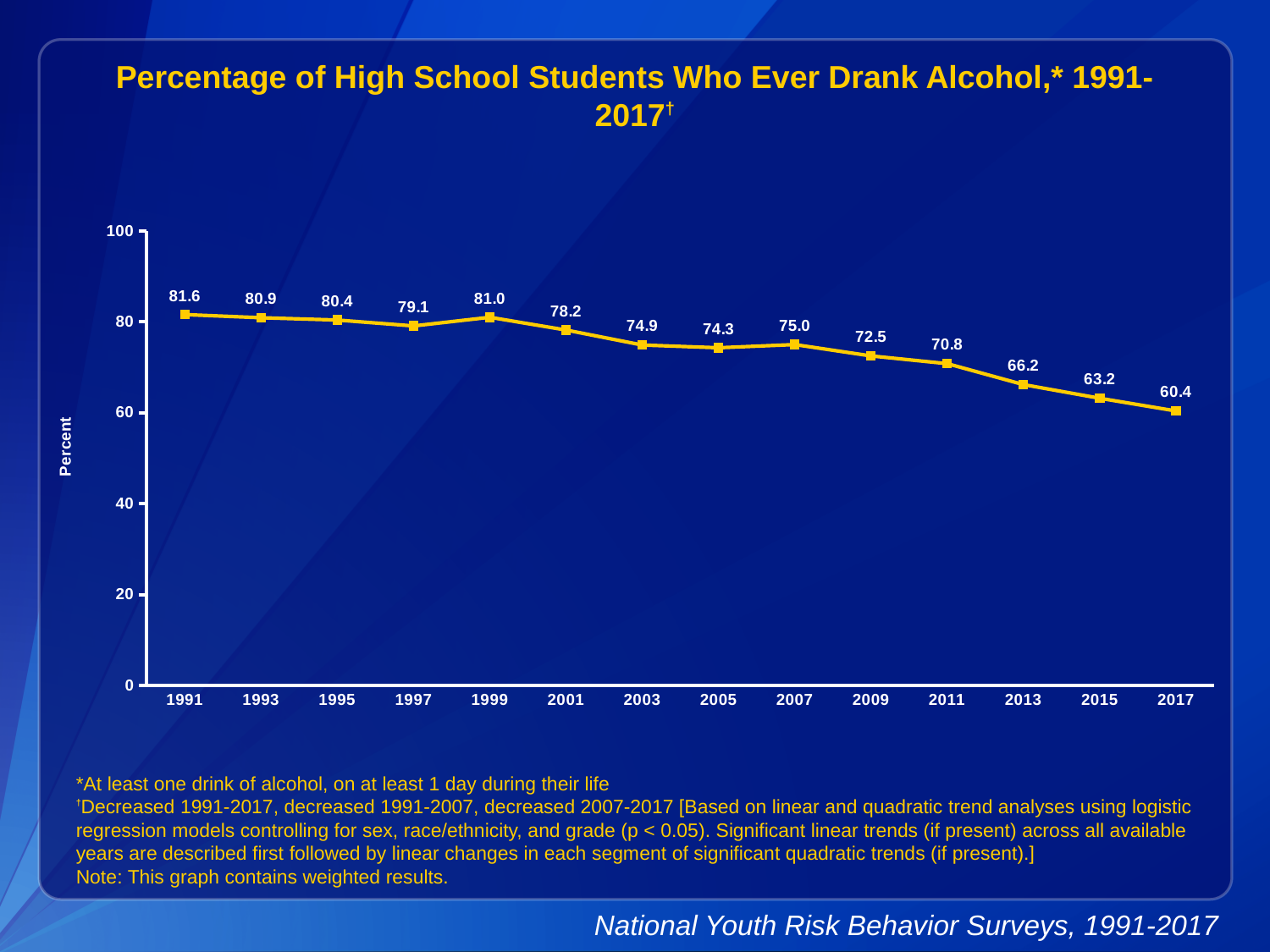
What is the label on the y axis? Percent What is the value for 1991? 81.6 How many years are plotted on the chart? 14 Which is larger, the value for 1999 or the value for 2001? 1999 What is the value for 2007? 75.0 What is the value for 2017? 60.4 Do the values generally rise or fall from 1991 to 2017? fall Which year has the highest value? 1991 What is the difference between the values for 1991 and 2017? 21.2 Is the value for 2013 greater or less than 60? greater What kind of chart is shown? line chart Which year has the lowest value? 2017